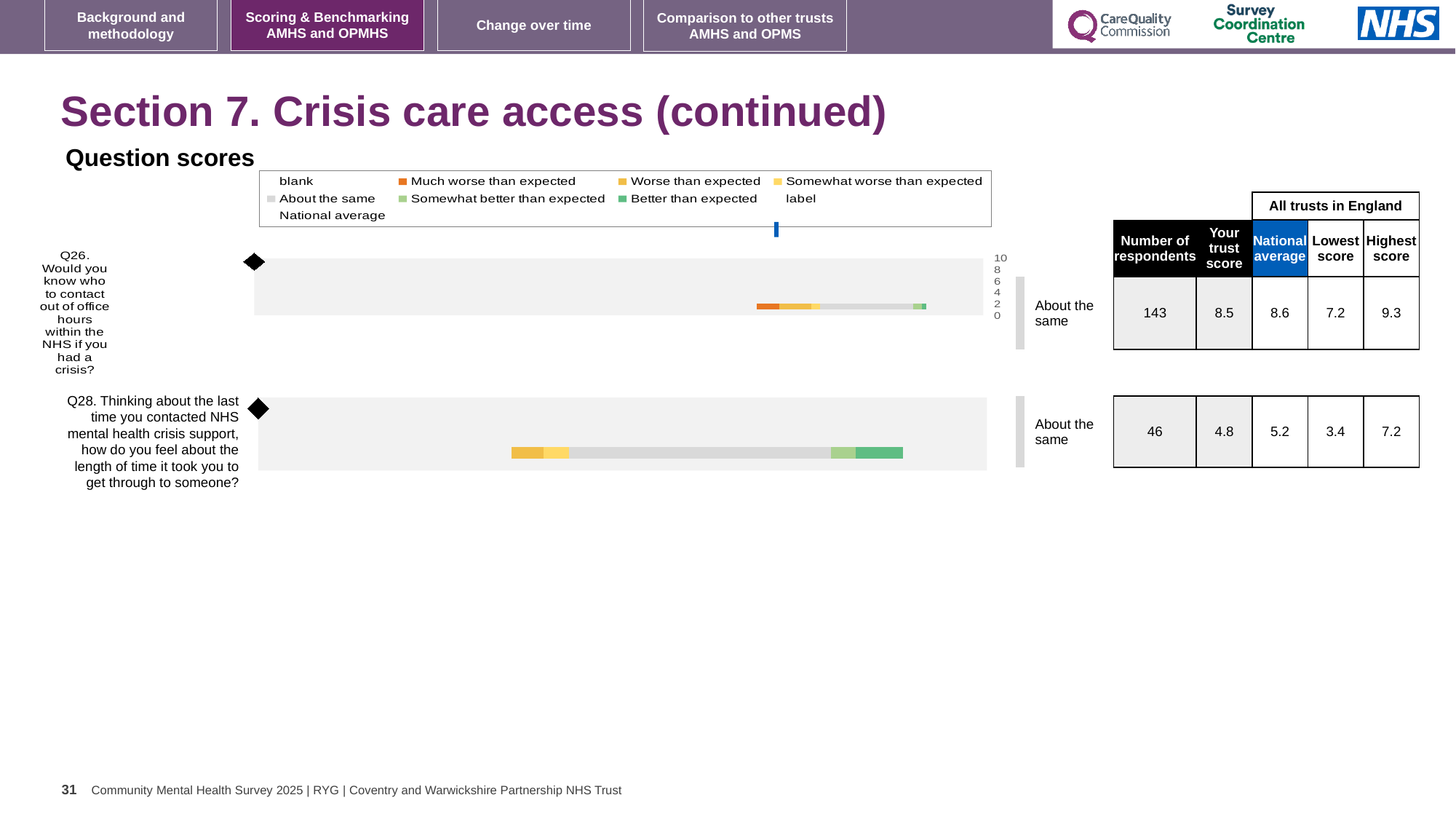
How many questions are plotted in the question scores chart? 2 Which question has the higher trust score in the table beside the chart, Q26 or Q28? Q26 According to the table beside the chart, what is the trust score for Q28? 4.8 What kind of chart is used to show the question scores on this slide? bar chart What is the difference between the highest score and the lowest score for Q26 in the table beside the chart? 2.1 What is the benchmark rating shown next to the bar for Q28? About the same According to the table beside the chart, how many respondents answered Q28? 46 What is the benchmark rating shown next to the bar for Q26? About the same According to the table beside the chart, what is the trust score for Q26? 8.5 According to the table beside the chart, what is the highest score among all trusts in England for Q28? 7.2 According to the table beside the chart, what is the national average for Q26? 8.6 Which legend entry is shown in orange in the question scores chart? Much worse than expected